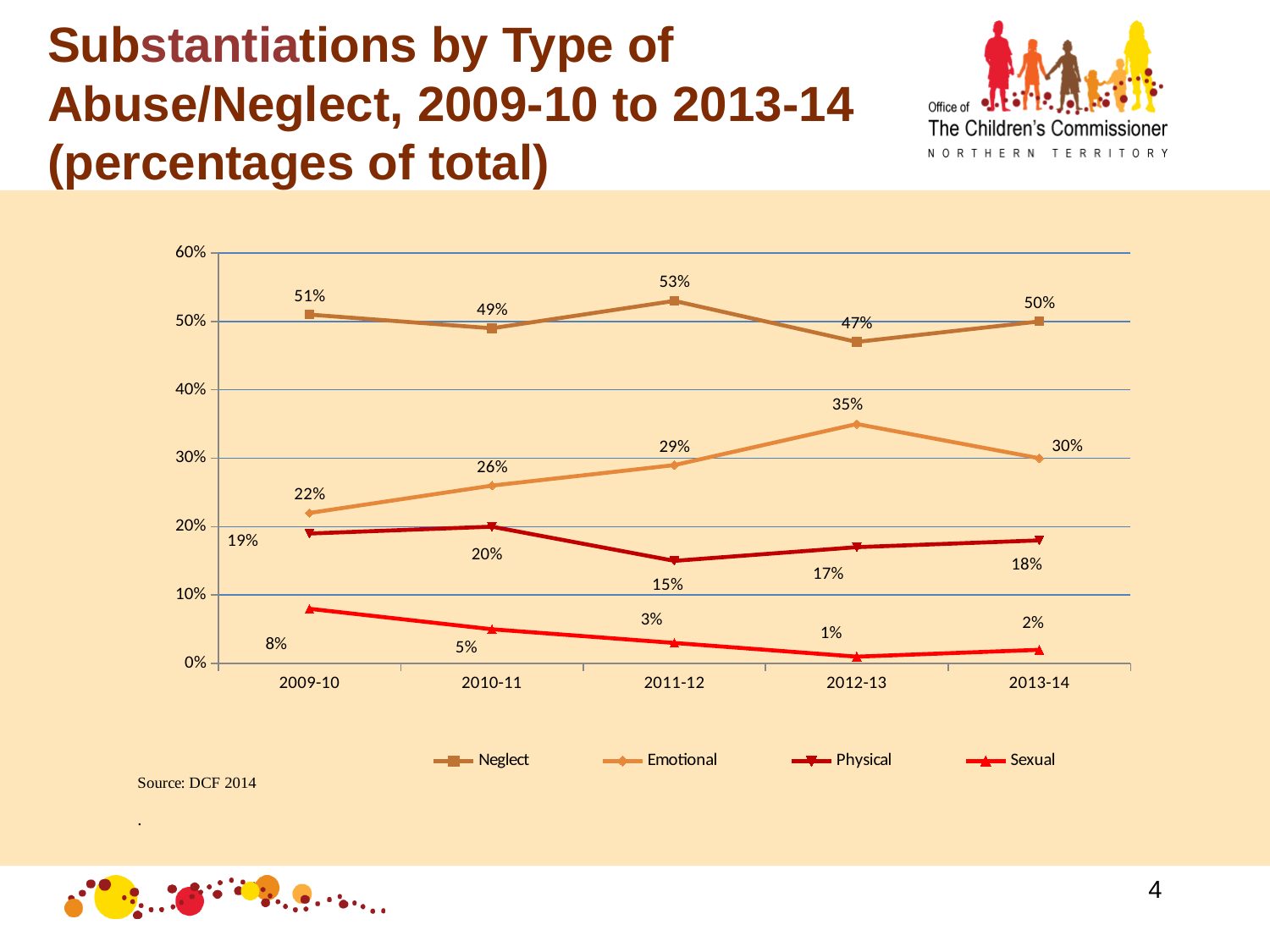
Does the Sexual series generally rise or fall from 2009-10 to 2012-13? Fall How many series does the legend list? 4 How many years are shown on the x axis? 5 What is the value for Sexual in 2013-14? 2% In which year is the Neglect value highest? 2011-12 What type of chart is shown on the slide? Line chart What is the value for Physical in 2009-10? 19% What is the value for Neglect in 2011-12? 53% In which year is the Sexual value lowest? 2012-13 Which is larger in 2010-11, the Emotional value or the Physical value? Emotional What is the value for Emotional in 2012-13? 35% What is the difference between the Emotional value in 2012-13 and in 2009-10? 13%